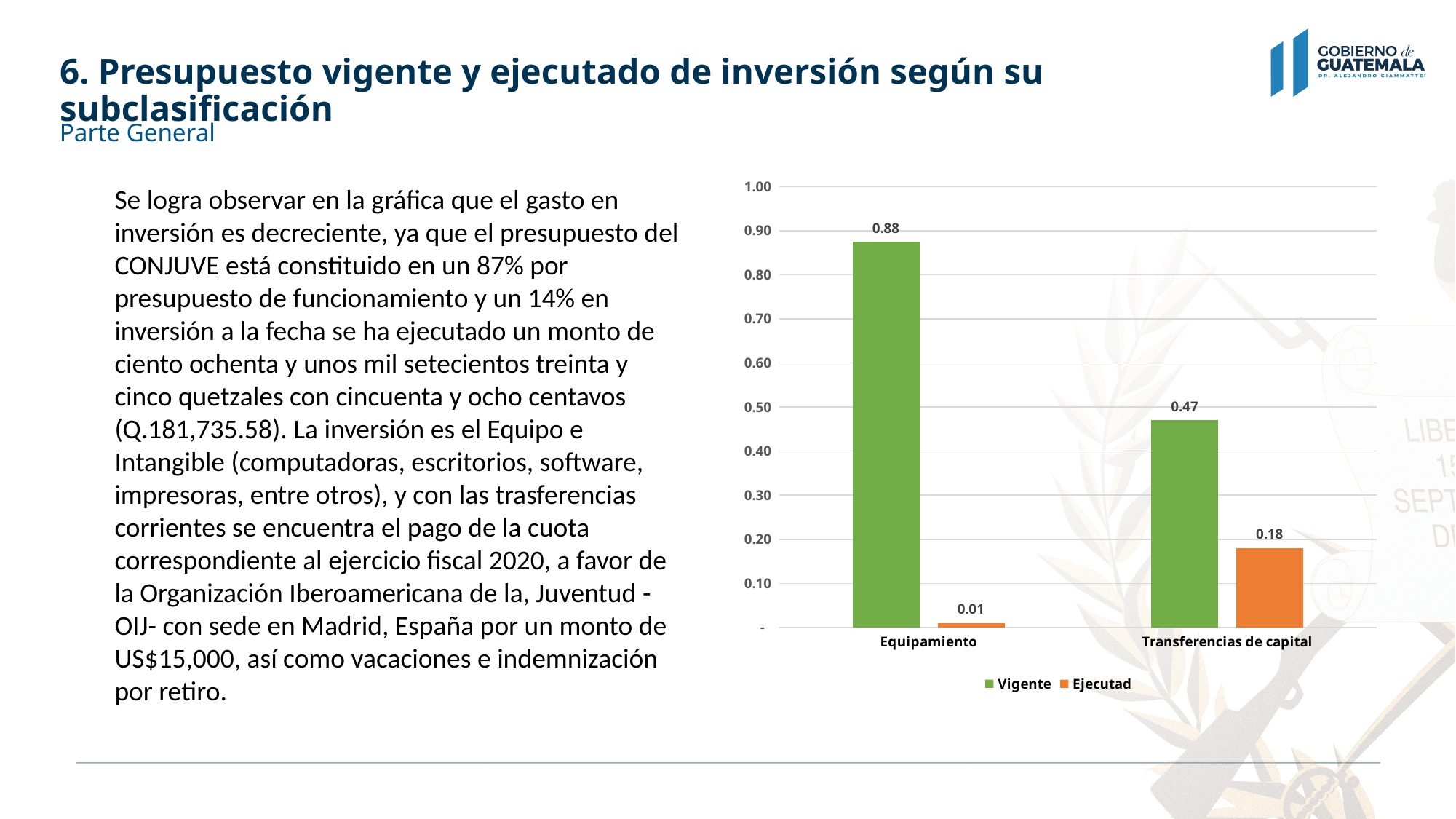
How many categories are shown on the x axis? 2 Which is larger: the Ejecutad value for Equipamiento or the Ejecutad value for Transferencias de capital? Transferencias de capital What is the difference between the Vigente values for Equipamiento and Transferencias de capital? 0.41 Which category has the highest Vigente value? Equipamiento What kind of chart is shown on the slide? Bar chart What is the Ejecutad value for Equipamiento? 0.01 How many series does the legend list? 2 What is the Vigente value for Equipamiento? 0.88 What is the Vigente value for Transferencias de capital? 0.47 Which category has the lowest Ejecutad value? Equipamiento What is the difference between the Vigente and Ejecutad values for Transferencias de capital? 0.29 What is the Ejecutad value for Transferencias de capital? 0.18